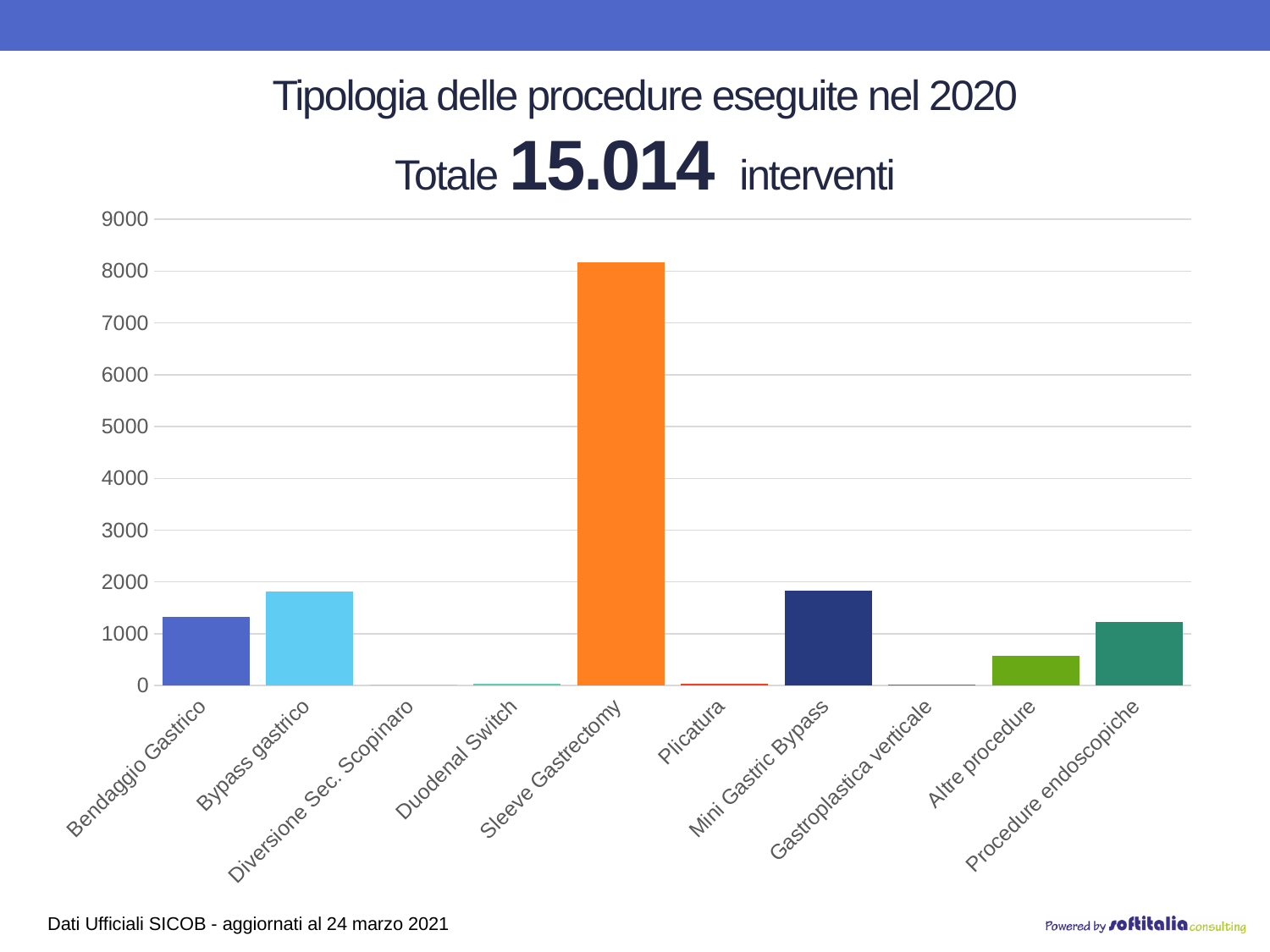
Is the value for Bendaggio Gastrico greater or less than 1000? greater How many procedure categories are shown on the x axis? 10 Which is larger, the value for Bendaggio Gastrico or the value for Altre procedure? Bendaggio Gastrico Is the value for Sleeve Gastrectomy greater or less than 8000? greater What kind of chart is shown on the slide? bar chart Is the value for Procedure endoscopiche greater or less than 1000? greater What is the title of the chart? Tipologia delle procedure eseguite nel 2020 Which is larger, the value for Sleeve Gastrectomy or the value for Mini Gastric Bypass? Sleeve Gastrectomy What total number of interventions is stated above the chart? 15.014 Which procedure has the highest number of interventions in the chart? Sleeve Gastrectomy